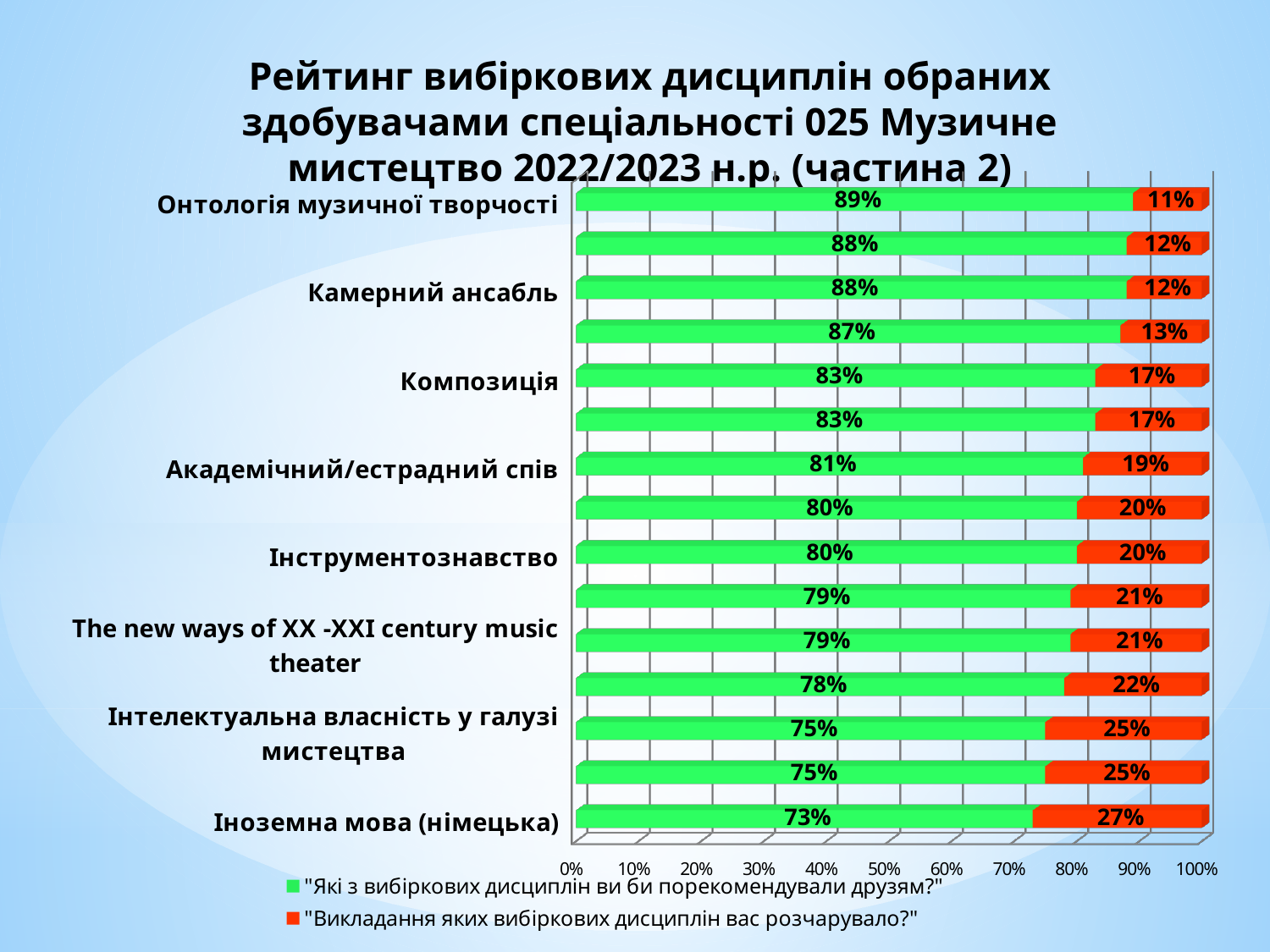
What is the green ("порекомендували друзям") value for Онтологія музичної творчості? 89% What kind of chart is shown on the slide? Bar chart (stacked horizontal) Which labelled discipline has the lowest green ("порекомендували друзям") value? Іноземна мова (німецька) What is the green value for Інтелектуальна власність у галузі мистецтва? 75% What is the difference between the green values for Онтологія музичної творчості and Іноземна мова (німецька)? 16 percentage points What is the green value for Композиція? 83% How many series does the legend list? 2 What is the red value for Академічний/естрадний спів? 19% What is the red ("розчарувало") value for Іноземна мова (німецька)? 27% How many bars (disciplines) are plotted in the chart? 15 Which colour represents the series "Викладання яких вибіркових дисциплін вас розчарувало?"? Red Which labelled discipline has the highest green ("порекомендували друзям") value? Онтологія музичної творчості